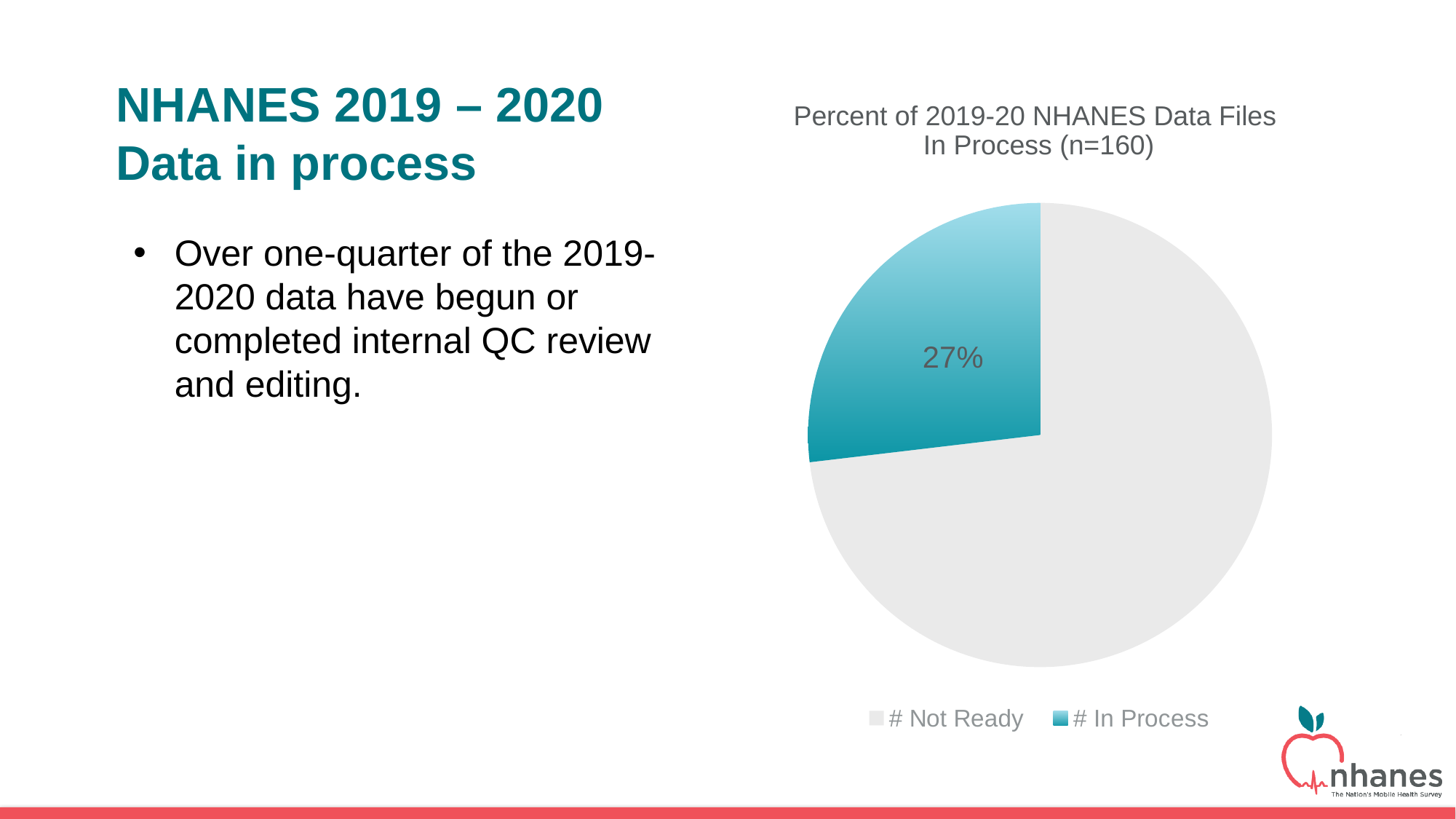
How many slices does the pie chart have? 2 What kind of chart is shown on the slide? pie chart Does the # Not Ready slice make up more or less than half of the pie? more How many entries does the legend list? 2 What colour is the # In Process slice? teal What share of the pie does # In Process represent? 27% What is the title of the pie chart? Percent of 2019-20 NHANES Data Files In Process (n=160) What percentage of the pie is labelled for the # In Process slice? 27% Which slice of the pie is the smallest? # In Process Which slice of the pie is the largest? # Not Ready Which is larger, the # Not Ready slice or the # In Process slice? # Not Ready